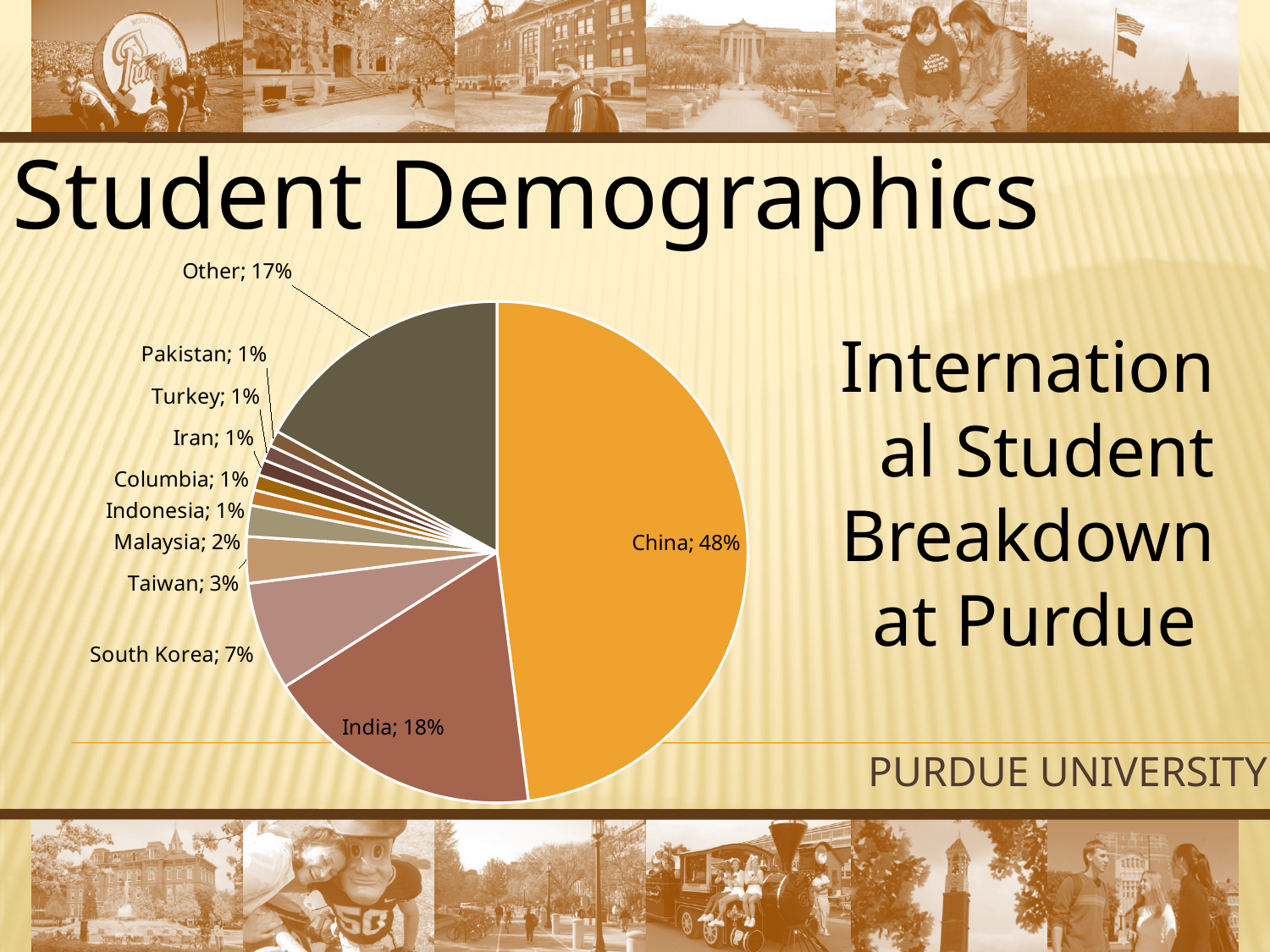
What is the difference between the Other slice and the South Korea slice, in percentage points? 10 What is the value shown for South Korea? 7% Which is larger, the slice for South Korea or the slice for Taiwan? South Korea What is the difference in percentage points between China and India? 30 What percentage is shown for Taiwan? 3% What is the value for the Other slice? 17% How many slices does the pie chart have? 11 What share of international students at Purdue is from China? 48% What is the value shown for Malaysia? 2% What percentage of the pie is labelled India? 18% What kind of chart is shown on the slide? pie chart Which country has the largest slice of the pie? China